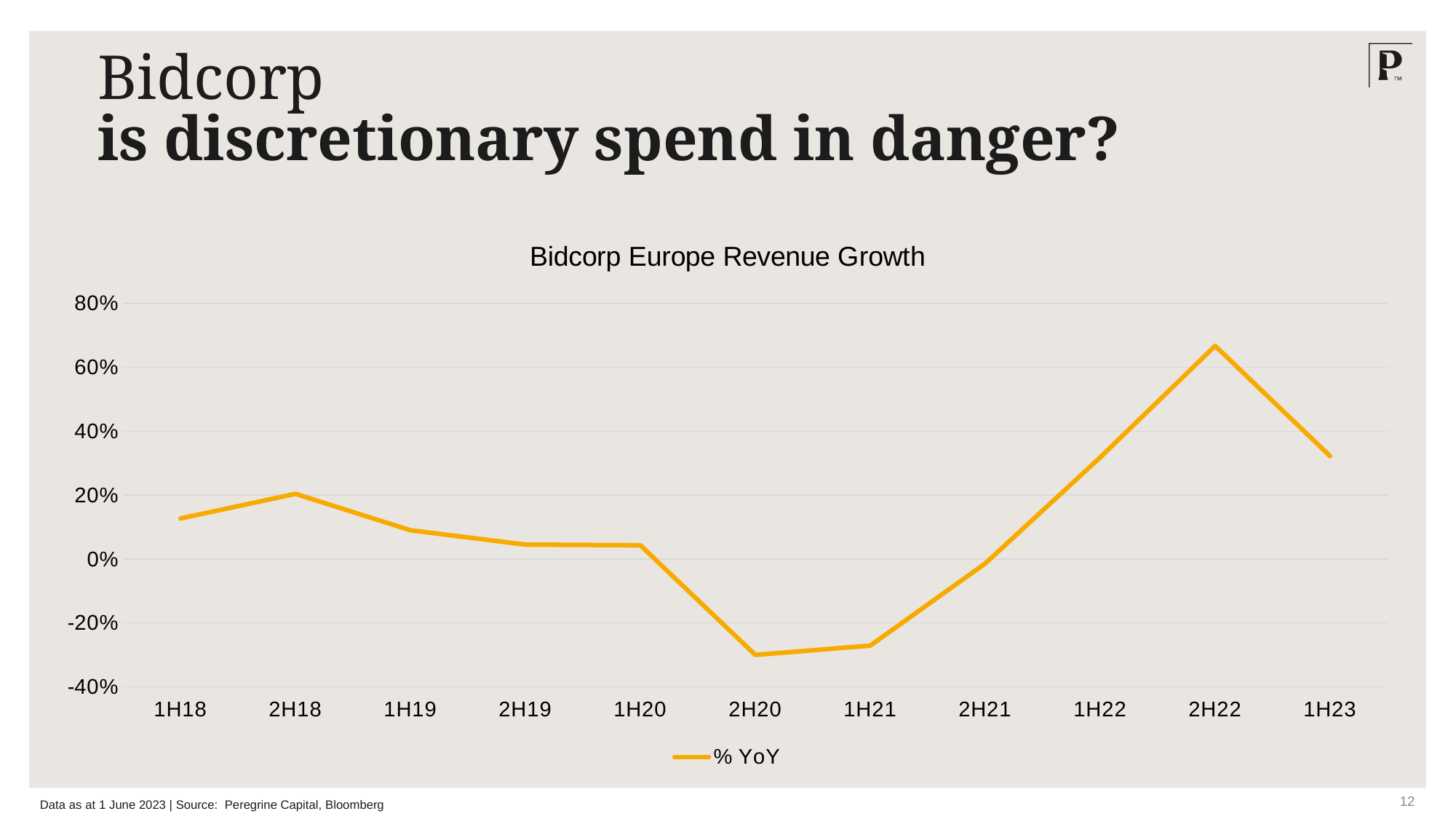
Do the values rise or fall from 1H21 to 2H22? rise What is the title of the chart? Bidcorp Europe Revenue Growth What kind of chart is shown on the slide? line chart Which is larger, the value for 2H22 or the value for 1H23? 2H22 Is the value for 1H23 greater or less than 20%? greater Which period has the highest revenue growth? 2H22 Is the value for 2H22 greater or less than 60%? greater Is the value for 2H20 greater or less than -20%? less How many periods are plotted along the x axis? 11 Which period has the lowest revenue growth? 2H20 What is the name of the series shown in the legend? % YoY How many series does the legend list? 1